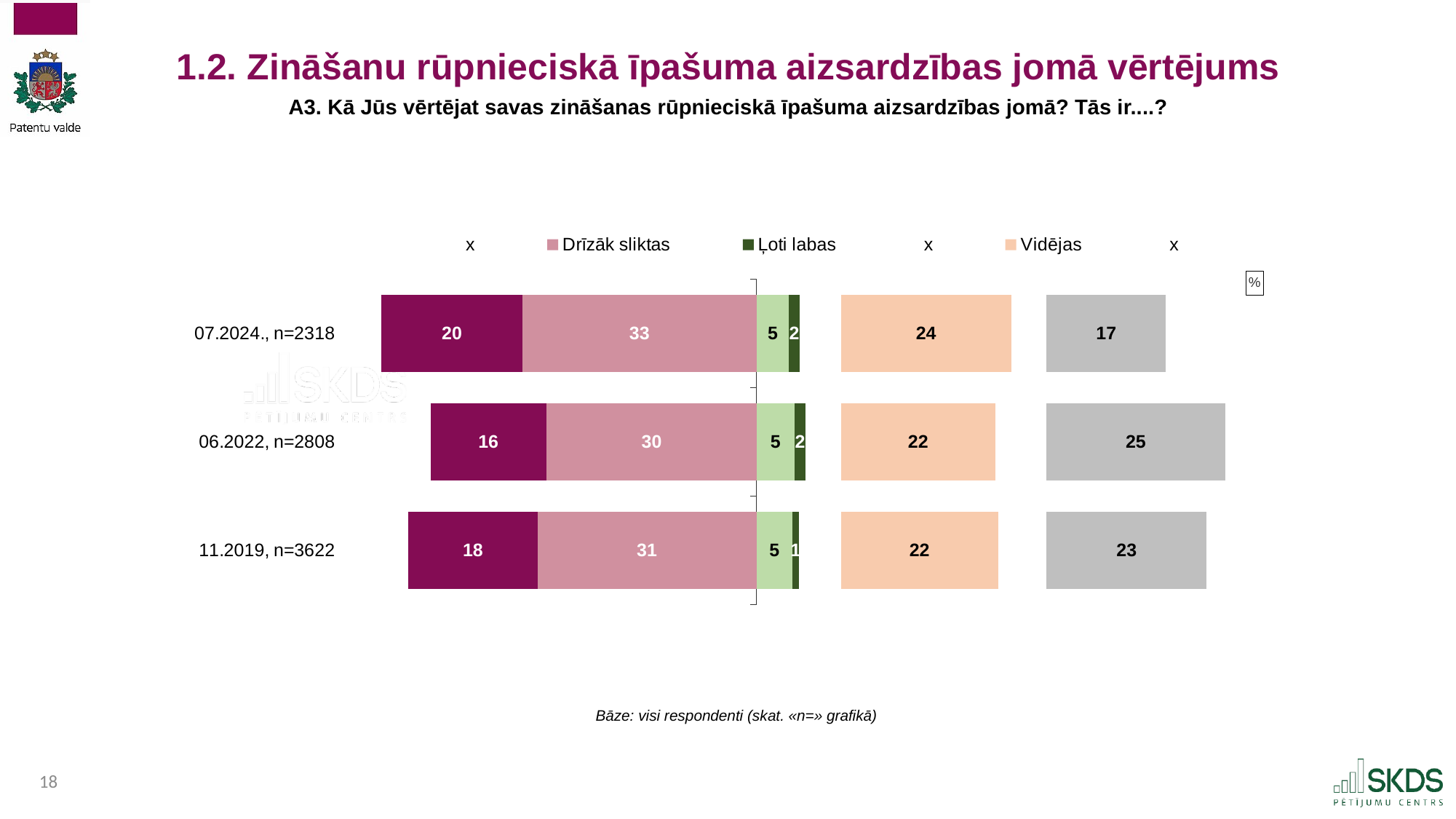
What is the value for Ļoti labas in the 07.2024., n=2318 bar? 2 How many survey waves (bars) are shown in the chart? 3 What is the difference between the Drīzāk sliktas values for 07.2024., n=2318 and 06.2022, n=2808? 3 Which is larger: the Vidējas value for 07.2024., n=2318 or for 11.2019, n=3622? 07.2024., n=2318 What is the value for Drīzāk sliktas in the 07.2024., n=2318 bar? 33 What colour represents the Vidējas series in the chart? Light orange (peach) What kind of chart is shown on the slide? Stacked bar chart Which survey wave has the highest value for Drīzāk sliktas? 07.2024., n=2318 What is the value for Ļoti labas in the 11.2019, n=3622 bar? 1 Which survey wave has the highest value for Vidējas? 07.2024., n=2318 Which survey wave has the lowest value for Drīzāk sliktas? 06.2022, n=2808 What is the value for Vidējas in the 06.2022, n=2808 bar? 22